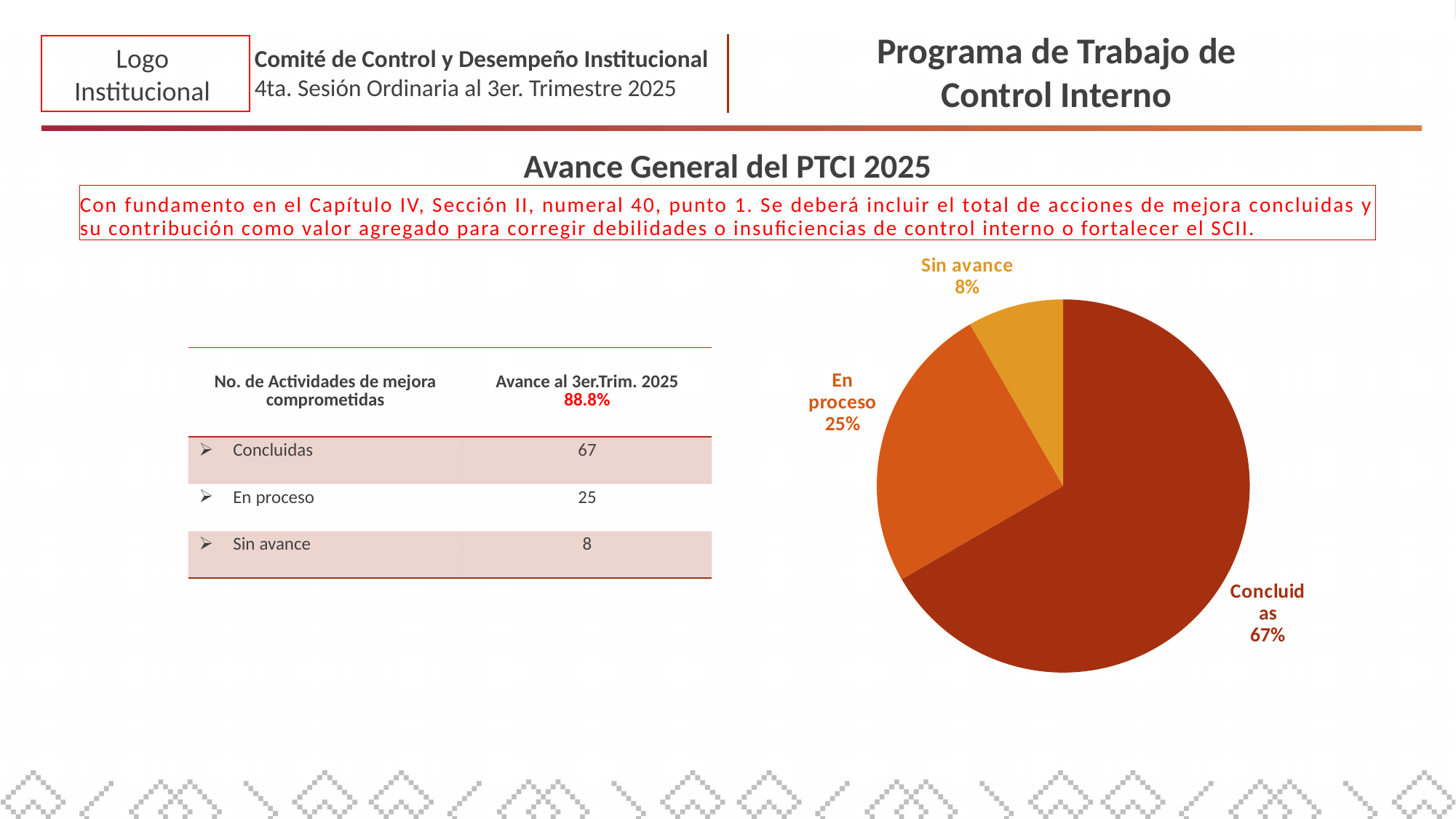
What percentage does the pie chart show for En proceso? 25% Which slice of the pie chart is the smallest? Sin avance What is the difference in percentage points between the Concluidas slice and the En proceso slice? 42 Which slice of the pie chart is the largest? Concluidas What percentage does the pie chart show for Sin avance? 8% What colour is the Sin avance slice in the pie chart? Yellow-orange What share of the pie does the Concluidas slice represent? 67% How many slices does the pie chart have? 3 What kind of chart is shown on the slide? Pie chart Which is larger in the pie chart, En proceso or Sin avance? En proceso What percentage does the pie chart show for Concluidas? 67% What is the title shown above the chart area on the slide? Avance General del PTCI 2025